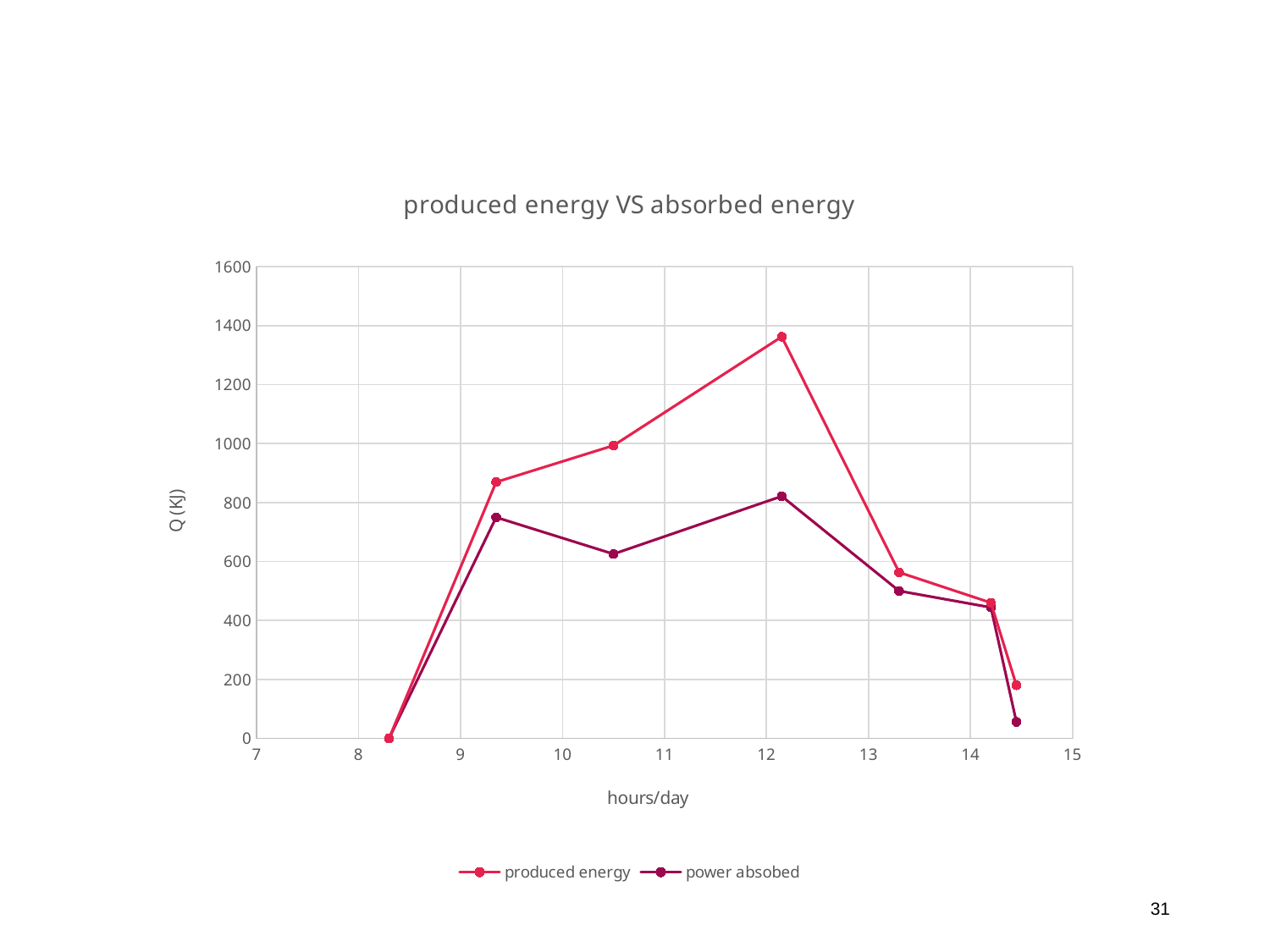
Is the last plotted value of the power absobed series (near 14.5 hours/day) greater or less than 200? less Is the produced energy value at about 9.35 hours/day greater or less than 800? greater How many data points are plotted for the produced energy series? 7 Is the peak value of the power absobed series greater or less than 1000? less Which series reaches the highest value on the chart? produced energy What is the label of the vertical axis? Q (KJ) What is the title of the chart? produced energy VS absorbed energy At around 10.5 hours/day, which series has the larger value, produced energy or power absobed? produced energy How many series does the legend list? 2 Does the produced energy series rise or fall between about 12 and 13.3 hours/day? fall What kind of chart is shown on the slide? line chart